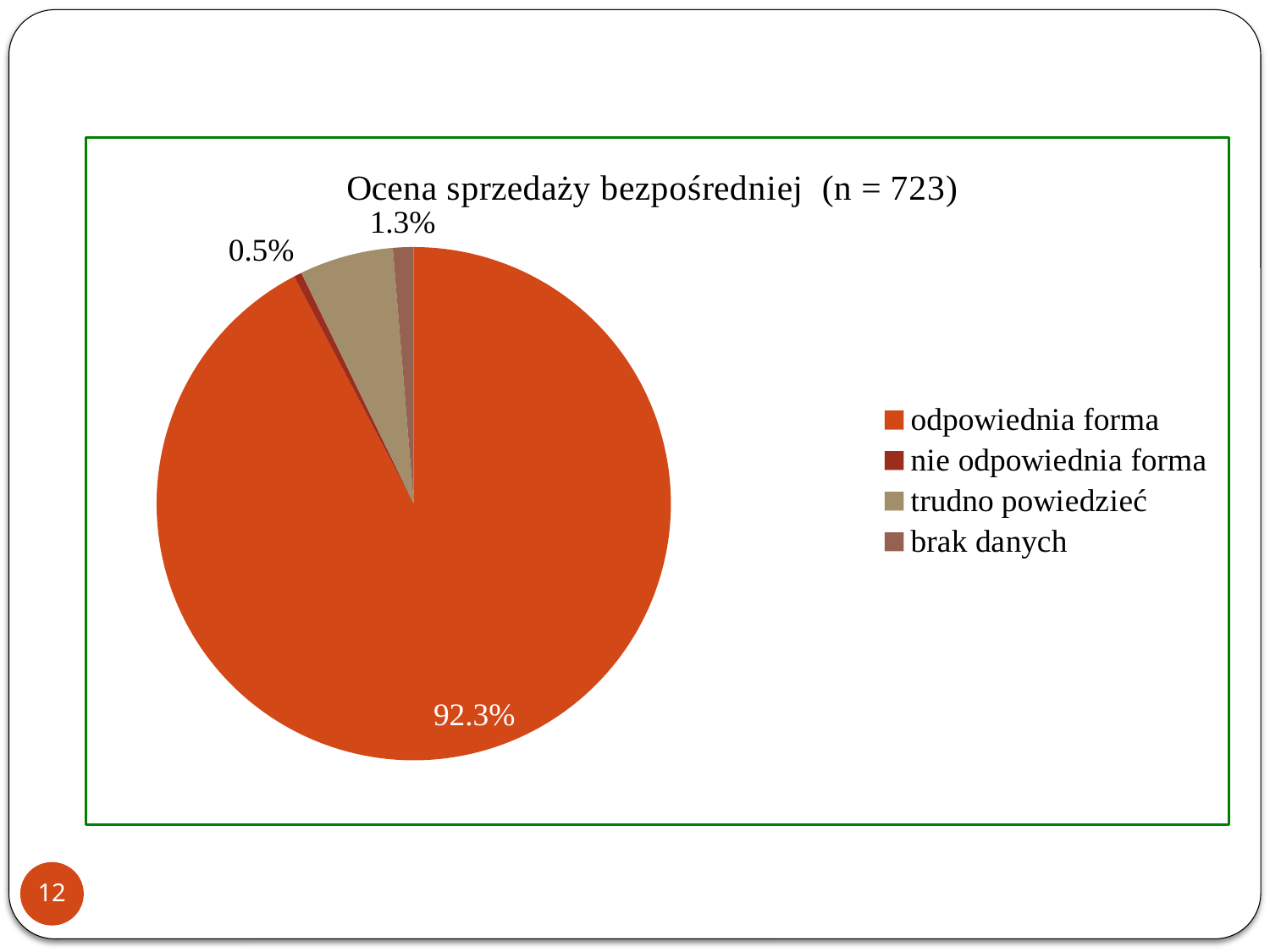
Which slice is larger: "trudno powiedzieć" or "brak danych"? trudno powiedzieć What is the difference in percentage points between "brak danych" and "nie odpowiednia forma"? 0.8 What type of chart is shown on the slide? pie chart What percentage of the pie is labelled for "odpowiednia forma"? 92.3% How many categories does the pie chart have? 4 What is the difference in percentage points between "odpowiednia forma" and "nie odpowiednia forma"? 91.8 What percentage is shown for "brak danych"? 1.3% Which slice is larger: "brak danych" or "nie odpowiednia forma"? brak danych Which category has the largest slice of the pie? odpowiednia forma What is the title of the chart? Ocena sprzedaży bezpośredniej (n = 723) Which category has the smallest slice of the pie? nie odpowiednia forma What percentage is shown for "nie odpowiednia forma"? 0.5%